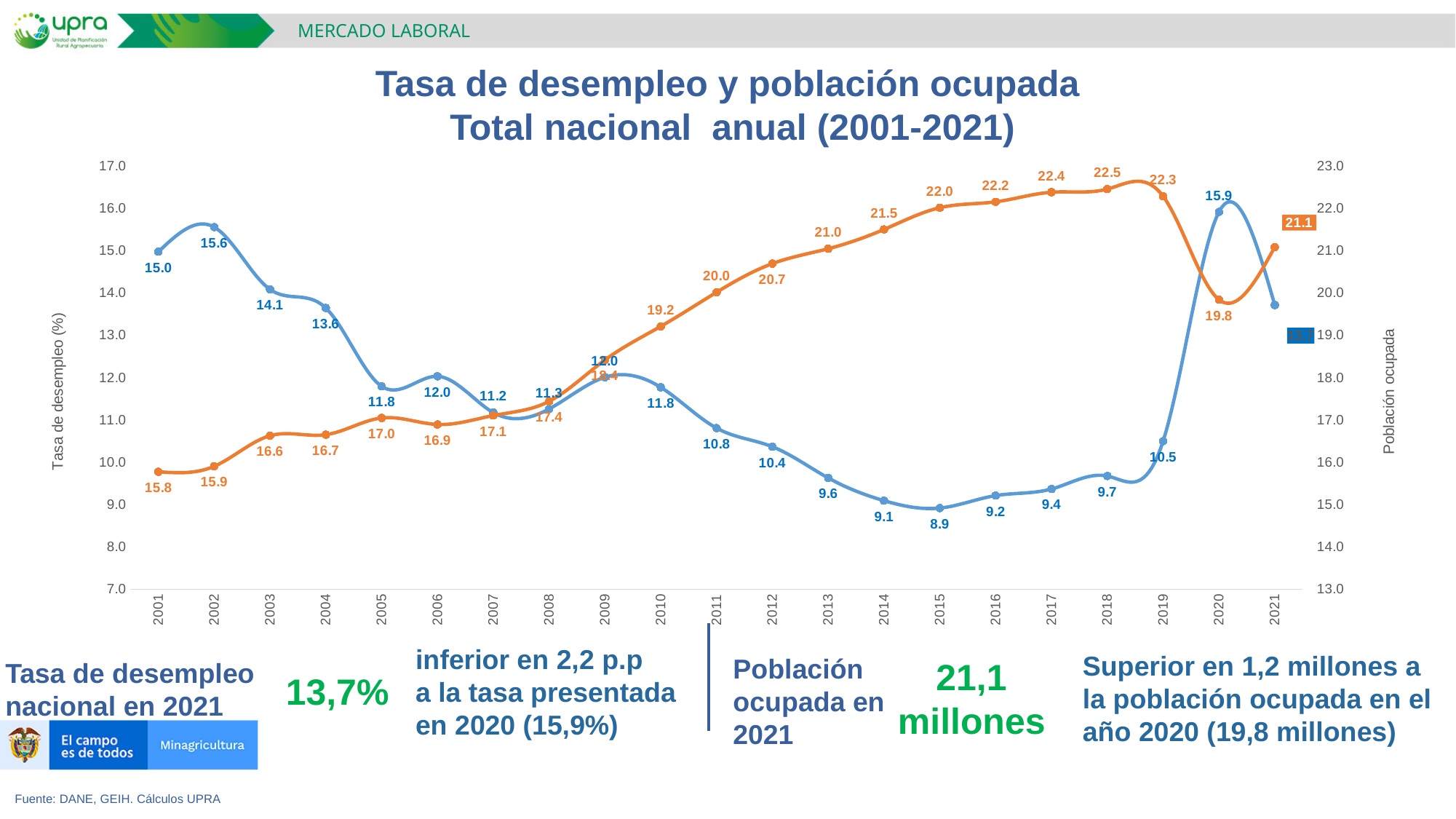
Did the employed population (Población ocupada) rise or fall from 2001 to 2018? Rise In which year was the unemployment rate lowest? 2015 Which year had a higher unemployment rate, 2010 or 2011? 2010 What is the difference between the employed population in 2019 and in 2020? 2.5 How many years are plotted on the x axis? 21 What was the employed population (Población ocupada) value in 2018? 22.5 In which year was the unemployment rate highest? 2020 What was the unemployment rate in 2001? 15.0 In which year was the employed population (Población ocupada) highest? 2018 What is the difference between the unemployment rate in 2002 and in 2003? 1.5 What kind of chart is shown on the slide? Line chart What was the unemployment rate (Tasa de desempleo) in 2015? 8.9